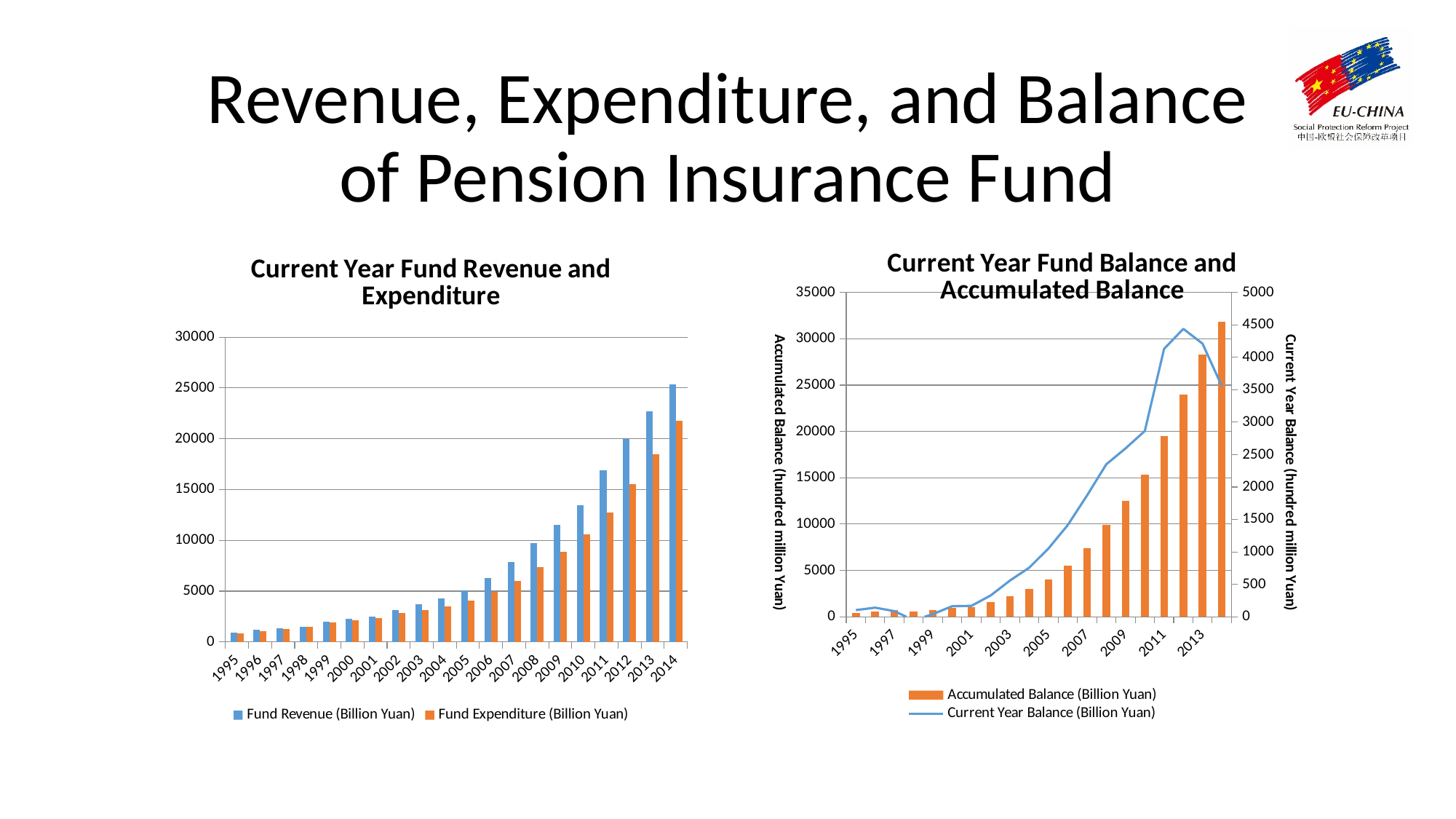
How many series does the legend of the 'Current Year Fund Revenue and Expenditure' chart list? 2 In the 'Current Year Fund Revenue and Expenditure' chart, does Fund Revenue rise or fall from 1995 to 2014? rise In the 'Current Year Fund Balance and Accumulated Balance' chart, which series is drawn as a line? Current Year Balance (Billion Yuan) In the 'Current Year Fund Balance and Accumulated Balance' chart, is the Accumulated Balance for the last year (2014) greater or less than 30000? greater What kind of chart is the 'Current Year Fund Revenue and Expenditure' chart? bar chart In the 'Current Year Fund Revenue and Expenditure' chart, which is larger in 2014, Fund Revenue or Fund Expenditure? Fund Revenue In the 'Current Year Fund Revenue and Expenditure' chart, is the Fund Expenditure for 2013 greater or less than 20000? less How many years are shown on the x axis of the 'Current Year Fund Revenue and Expenditure' chart? 20 In the 'Current Year Fund Balance and Accumulated Balance' chart, which year has the highest Accumulated Balance? 2014 In the 'Current Year Fund Revenue and Expenditure' chart, is the Fund Revenue for 2013 greater or less than 20000? greater In the 'Current Year Fund Revenue and Expenditure' chart, which year has the highest Fund Revenue? 2014 What is the label of the left vertical axis of the 'Current Year Fund Balance and Accumulated Balance' chart? Accumulated Balance (hundred million Yuan)